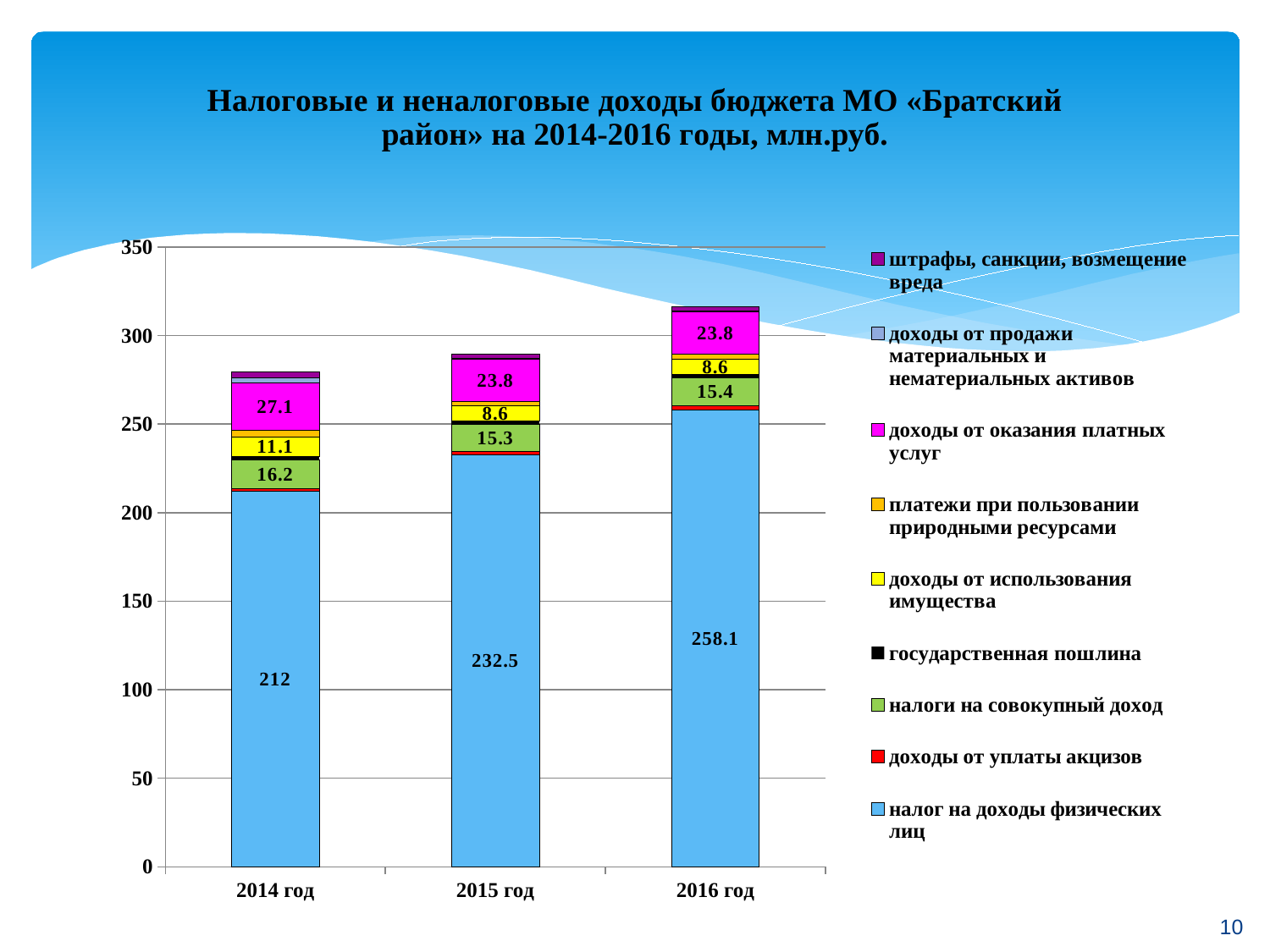
How many series does the legend list? 9 What is the value of «налог на доходы физических лиц» for 2014 год? 212 What is the value of «налог на доходы физических лиц» for 2016 год? 258.1 What is the value of «доходы от оказания платных услуг» for 2014 год? 27.1 By how much does «налог на доходы физических лиц» in 2016 год exceed that in 2014 год? 46.1 Is the total height of the 2016 год bar greater or less than 300? greater What is the difference between «доходы от использования имущества» in 2014 год and 2015 год? 2.5 Which year has the highest value for «налог на доходы физических лиц»? 2016 год Does «налог на доходы физических лиц» rise or fall from 2014 год to 2016 год? rise What is the value of «доходы от использования имущества» for 2014 год? 11.1 What is the value of «налоги на совокупный доход» for 2015 год? 15.3 Which year has the larger value for «доходы от оказания платных услуг», 2014 год or 2015 год? 2014 год